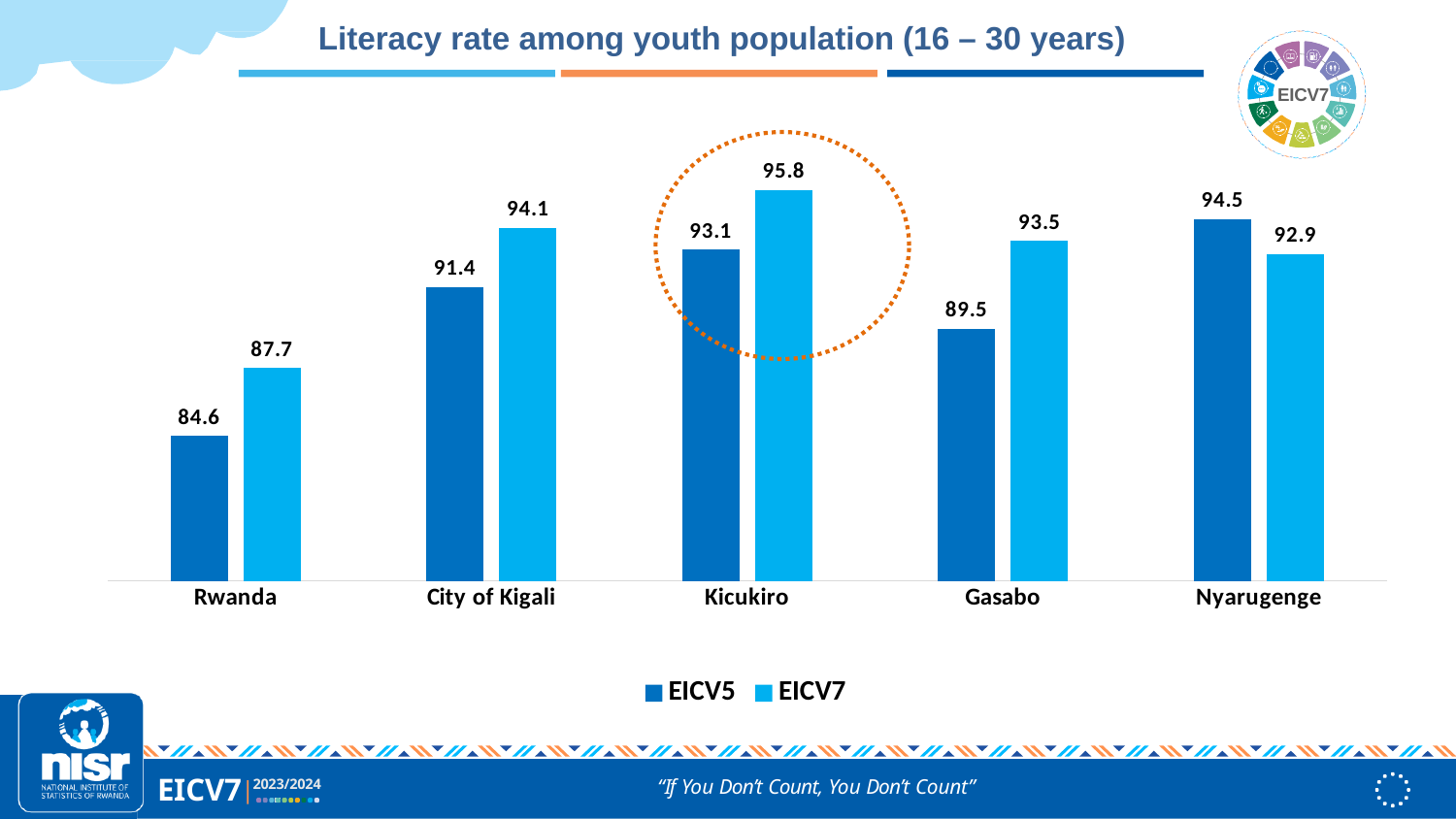
How many categories are shown on the x axis? 5 What is the EICV7 value for Gasabo? 93.5 How many series does the legend list? 2 What kind of chart is shown on the slide? Bar chart What is the difference between the EICV7 and EICV5 values for Gasabo? 4.0 Which category has the highest EICV7 value? Kicukiro For Nyarugenge, which is larger, the EICV5 value or the EICV7 value? EICV5 Which is larger, the EICV5 value for City of Kigali or the EICV5 value for Gasabo? City of Kigali What is the EICV7 literacy rate for Kicukiro? 95.8 What is the EICV5 literacy rate for Rwanda? 84.6 What is the difference between the EICV7 values for Kicukiro and Rwanda? 8.1 Which category has the lowest EICV5 value? Rwanda